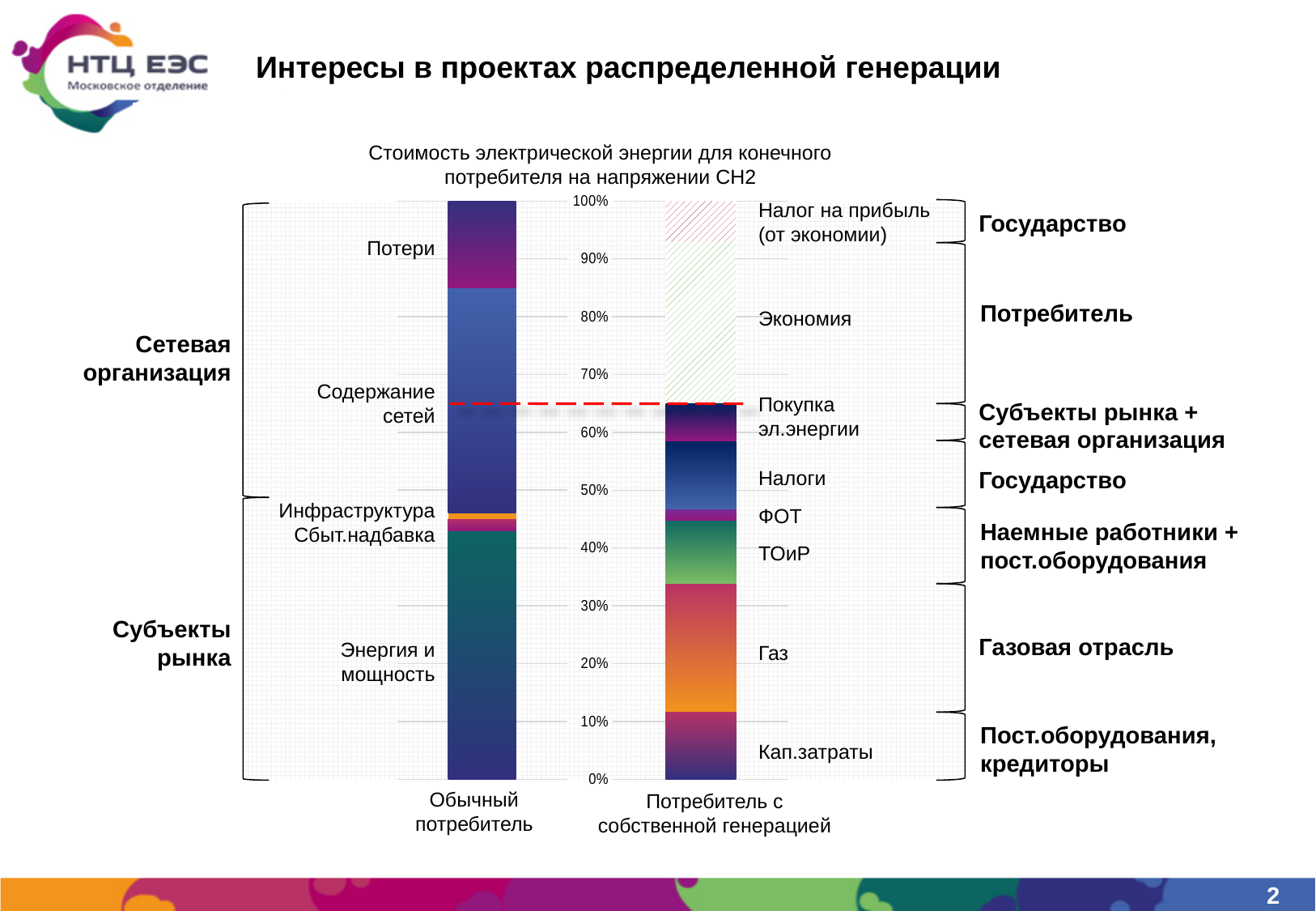
Is the top of the solid stacked bar for Потребитель с собственной генерацией greater or less than 70%? less What kind of chart is shown on the slide? Stacked bar chart How many bars (categories) are plotted on the chart? 2 What is the title of the chart? Стоимость электрической энергии для конечного потребителя на напряжении СН2 Which segment is at the bottom of the Потребитель с собственной генерацией bar? Кап.затраты What are the two categories on the x axis of the chart? Обычный потребитель; Потребитель с собственной генерацией Is the top of the solid stacked bar for Потребитель с собственной генерацией greater or less than 60%? greater Which segment is at the bottom of the Обычный потребитель bar? Энергия и мощность Is the top of the Потери segment in the Обычный потребитель bar greater or less than 90%? greater Which bar reaches a higher total on the chart, Обычный потребитель or Потребитель с собственной генерацией (solid segments only)? Обычный потребитель